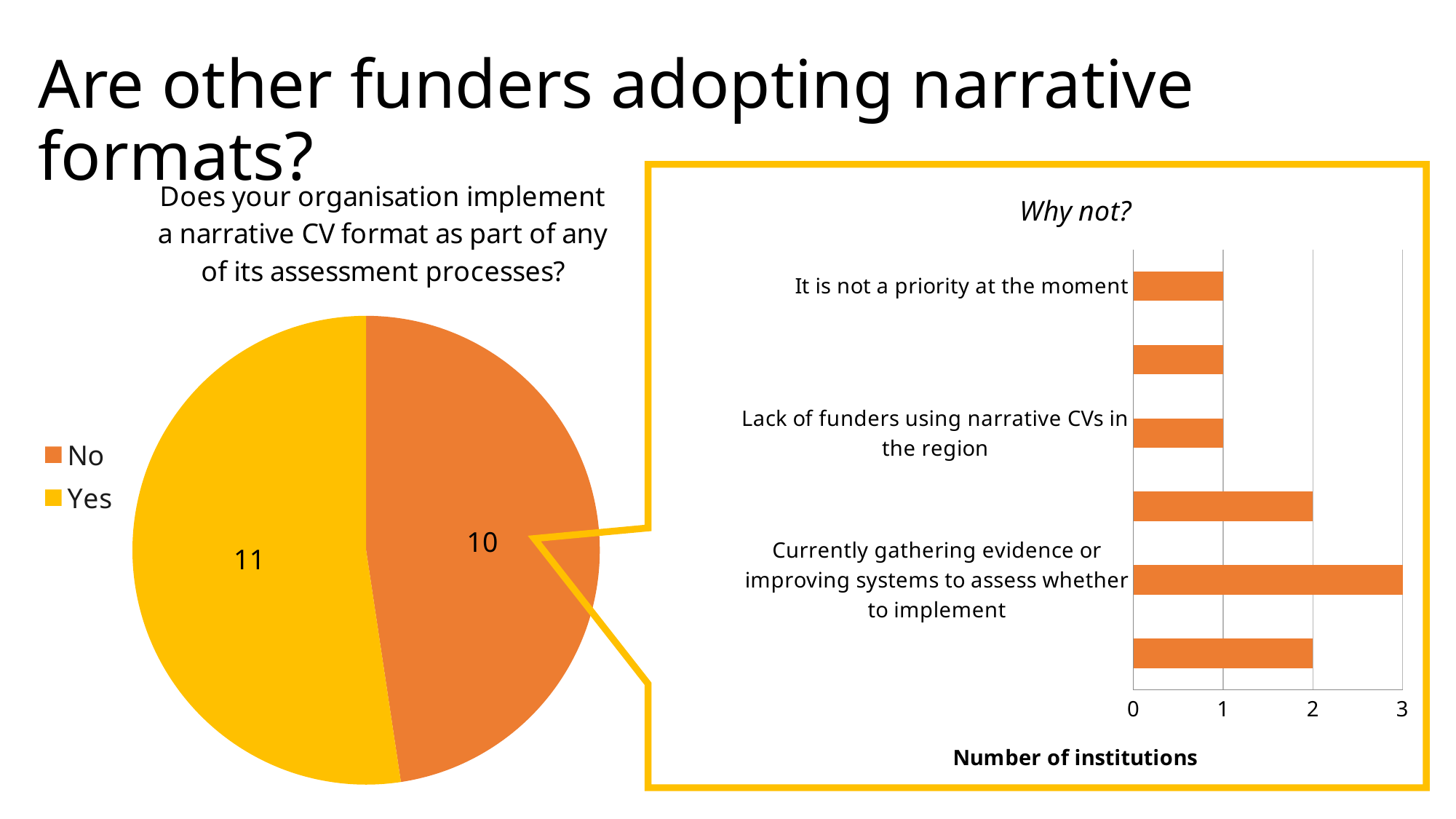
In the 'Why not?' chart, what is the value for 'It is not a priority at the moment'? 1 In the pie chart 'Does your organisation implement a narrative CV format as part of any of its assessment processes?', what is the value for Yes? 11 How many bars are plotted in the 'Why not?' chart? 6 In the pie chart on the left, what is the difference between the Yes and No values? 1 What kind of chart is the chart on the left of the slide? Pie chart In the pie chart 'Does your organisation implement a narrative CV format as part of any of its assessment processes?', what is the value for No? 10 How many entries does the legend of the pie chart on the left list? 2 In the 'Why not?' chart, what is the value for 'Lack of funders using narrative CVs in the region'? 1 In the 'Why not?' chart, which category has the highest value? Currently gathering evidence or improving systems to assess whether to implement In the 'Why not?' chart, what is the value for 'Currently gathering evidence or improving systems to assess whether to implement'? 3 What is the horizontal axis title of the 'Why not?' chart? Number of institutions In the pie chart on the left, which slice is larger, Yes or No? Yes